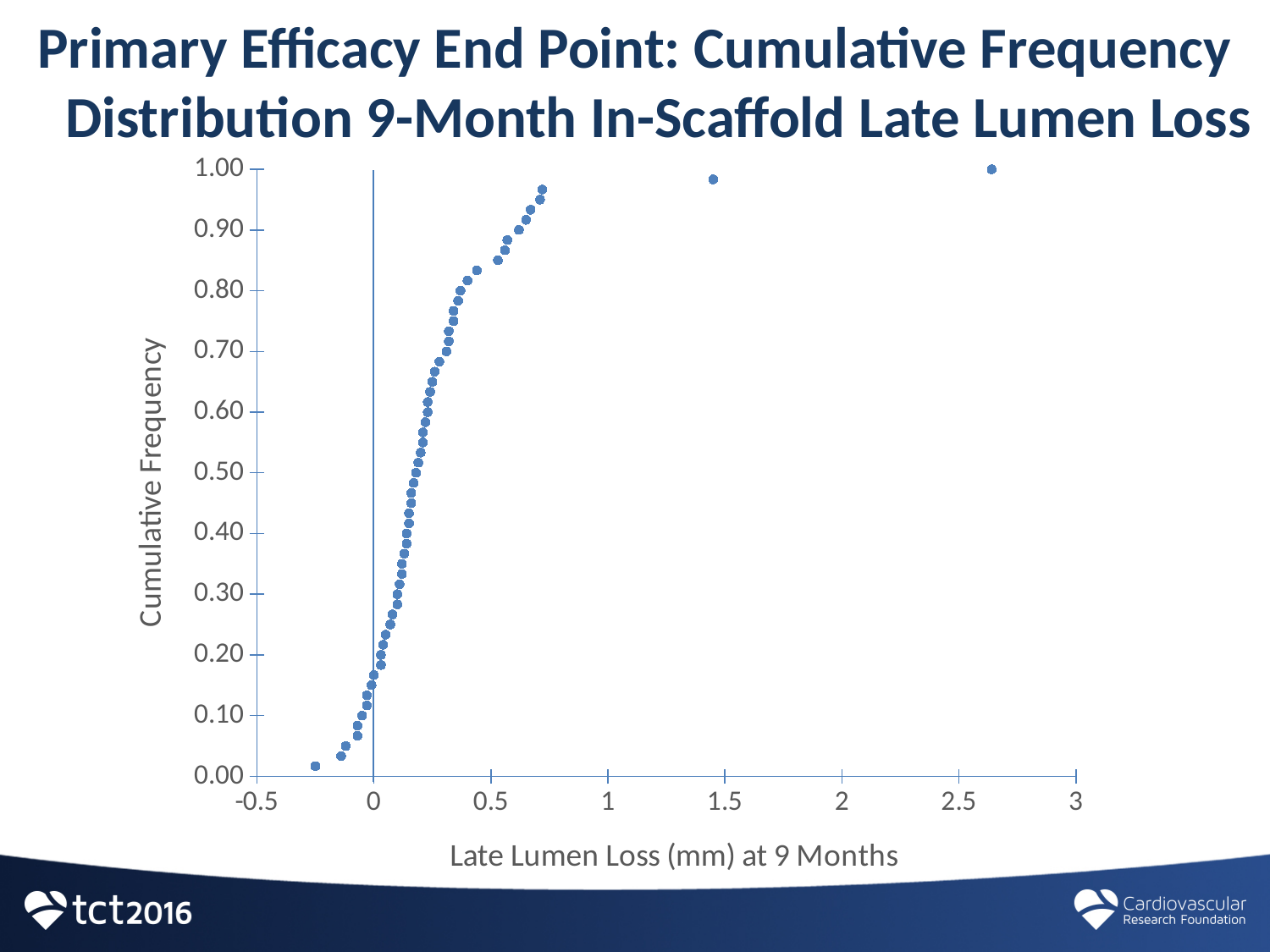
What is the title of the y axis? Cumulative Frequency Is the late lumen loss of the lowest point (smallest cumulative frequency) greater or less than 0? less Is the cumulative frequency of the rightmost point greater or less than 0.90? greater As late lumen loss increases along the x axis, does the cumulative frequency rise or fall? rise What is the title of the x axis? Late Lumen Loss (mm) at 9 Months Is the late lumen loss of the second-rightmost (isolated) point greater or less than 1? greater What kind of chart is shown on the slide? scatter chart